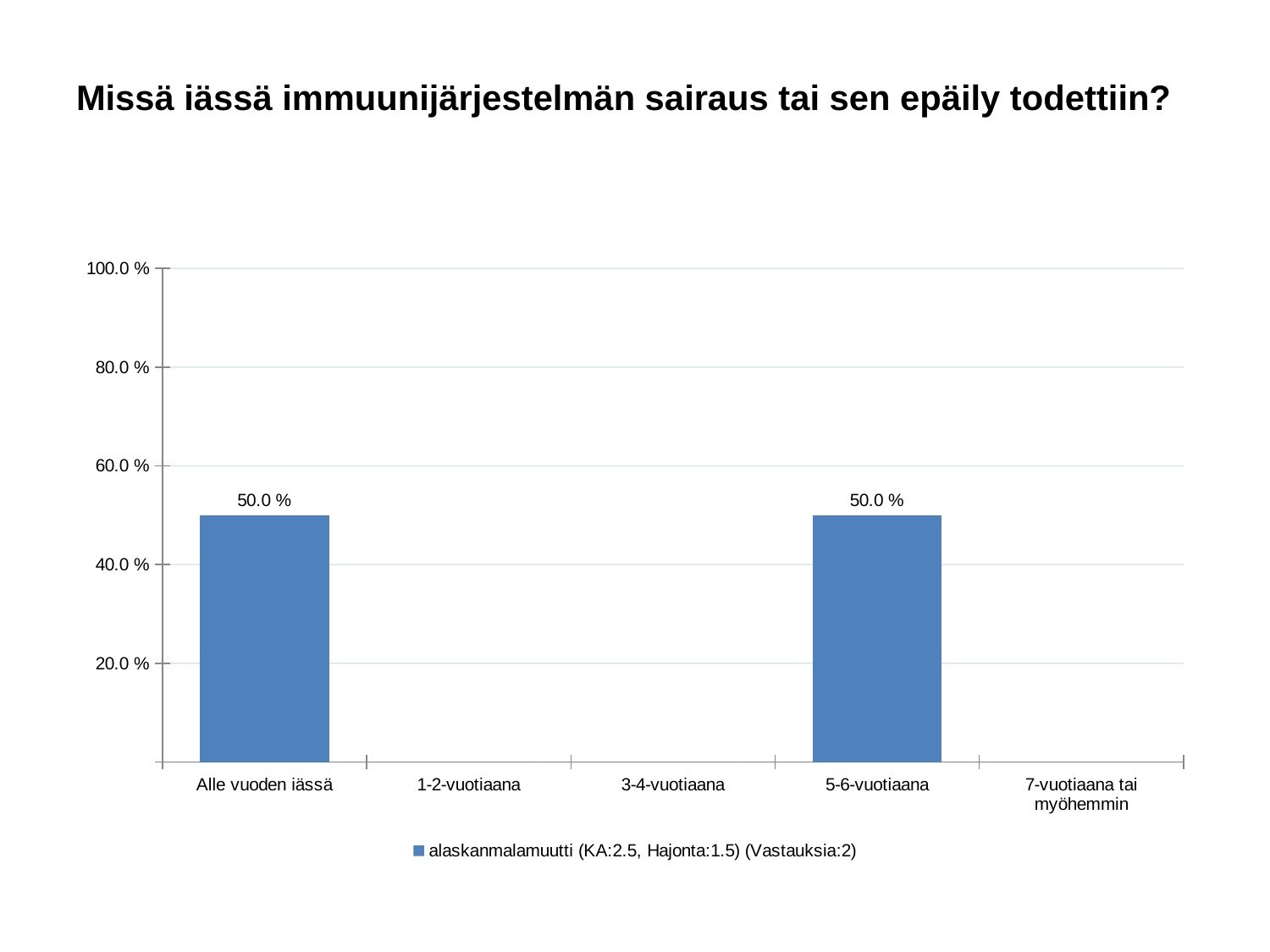
What is the title of the chart? Missä iässä immuunijärjestelmän sairaus tai sen epäily todettiin? What kind of chart is shown on the slide? bar chart What is the total of the values for "Alle vuoden iässä" and "5-6-vuotiaana"? 100.0 % How many series does the legend list? 1 How many categories are shown on the x axis? 5 Is the value for "Alle vuoden iässä" greater or less than 40.0 %? greater What is the difference between the values for "Alle vuoden iässä" and "5-6-vuotiaana"? 0.0 % What is the value for "5-6-vuotiaana"? 50.0 % Which categories have a visible bar in the chart? Alle vuoden iässä and 5-6-vuotiaana What is the value for "Alle vuoden iässä"? 50.0 % Is the value for "5-6-vuotiaana" greater or less than 60.0 %? less